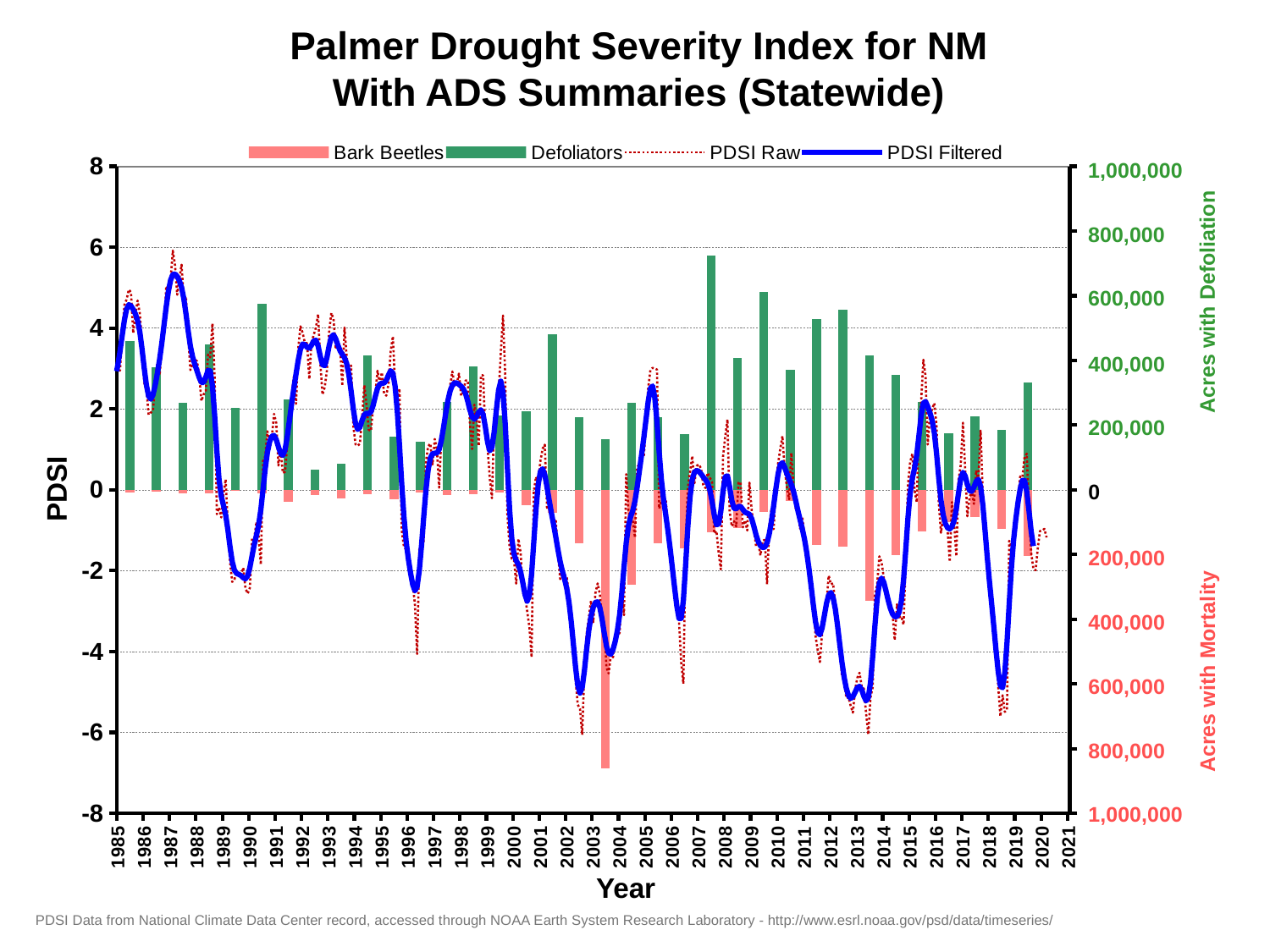
Which year has the larger Bark Beetles value, 2003 or 2013? 2003 In which year does the PDSI Filtered line reach its highest value? 1987 Is the Defoliators value for 2007 greater or less than 600,000 acres? greater How many series does the legend list? 4 Is the Defoliators value for 1990 greater or less than 400,000 acres? greater In which year is the Defoliators bar the tallest? 2007 Is the Bark Beetles value for 2003 greater or less than 800,000 acres? greater In which year is the Bark Beetles bar the largest? 2003 What is the title of the chart? Palmer Drought Severity Index for NM With ADS Summaries (Statewide) What kind of chart is this? Combination bar and line chart Which year has the larger Defoliators value, 2007 or 2009? 2007